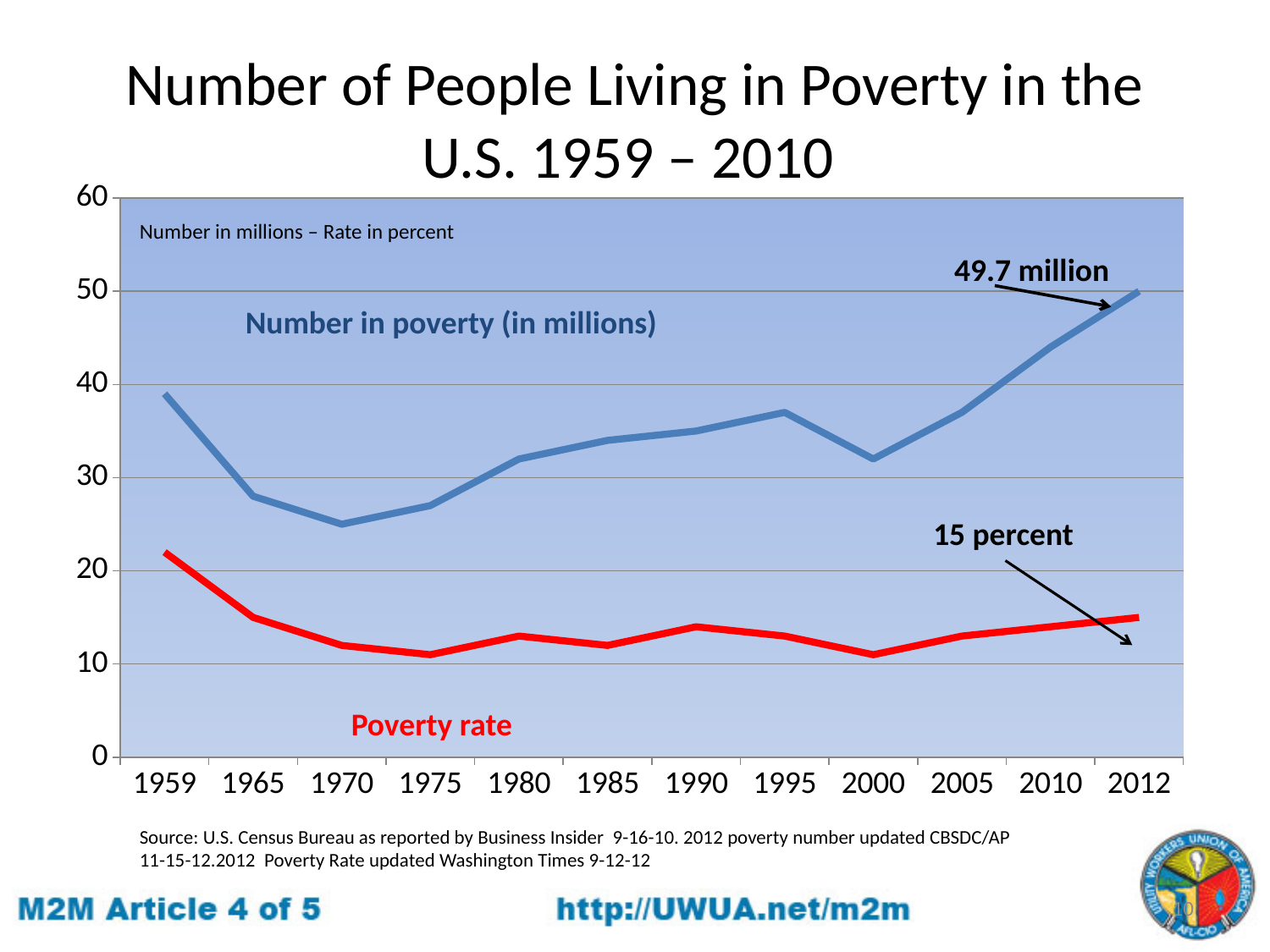
Which year has a larger number in poverty, 1959 or 1965? 1959 In which year is the number in poverty lowest? 1970 What is the number of people in poverty in 2012, as annotated on the chart? 49.7 million Is the poverty rate for 2000 greater or less than 20? less Does the number in poverty rise or fall from 2000 to 2012? rise In which year is the number in poverty highest? 2012 How many years are plotted along the x axis? 12 In which year is the poverty rate highest? 1959 What is the poverty rate in 2012, as annotated on the chart? 15 percent How many data series are plotted on the chart? 2 Is the number in poverty for 1959 greater or less than 30? greater What kind of chart is shown on the slide? line chart